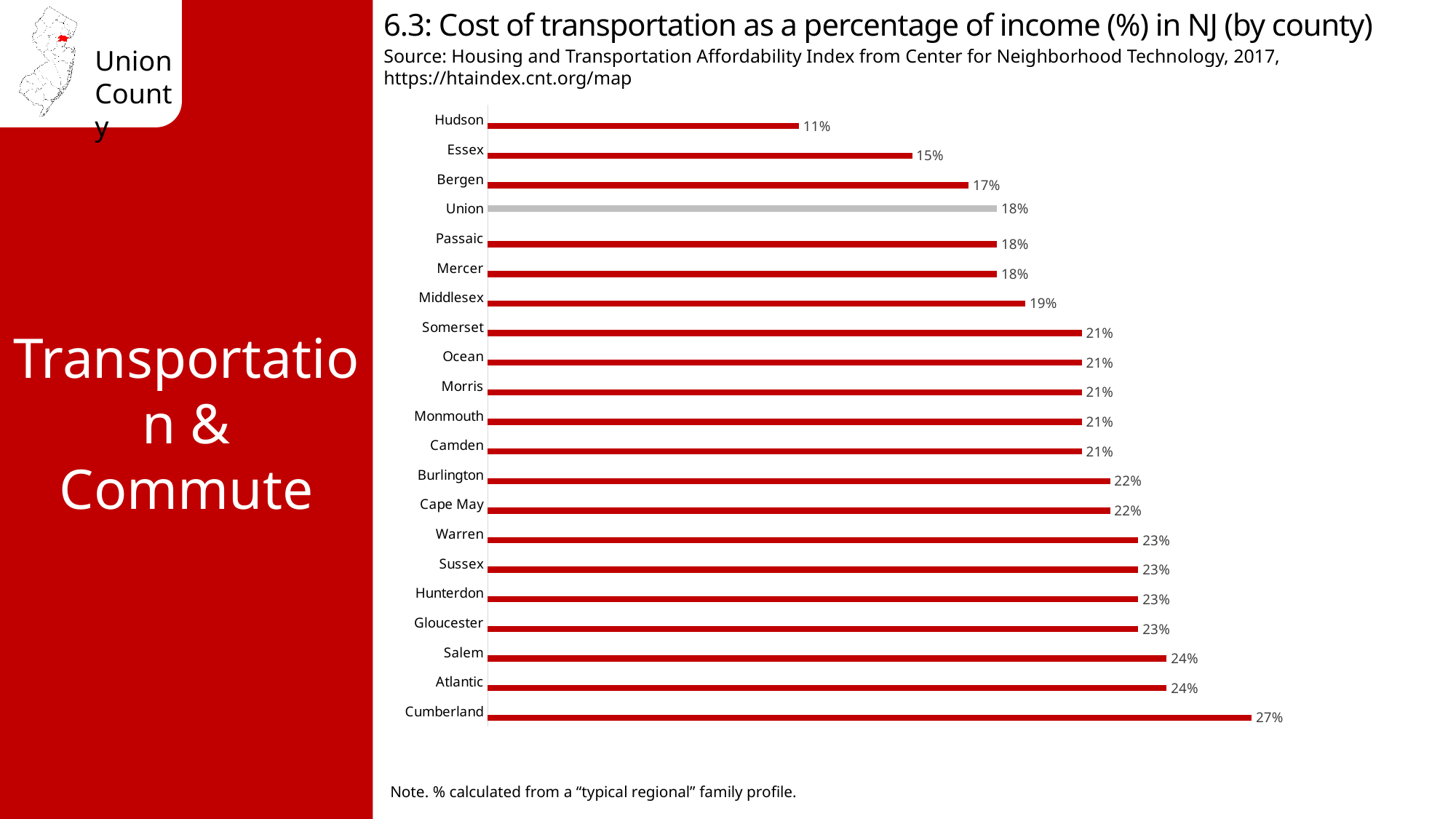
Which county has the lowest cost of transportation as a percentage of income? Hudson What is the difference in percentage points between Union and Essex? 3 Which county has a higher cost of transportation as a percentage of income, Essex or Warren? Warren What is the difference in percentage points between Cumberland and Hudson? 16 Which county's bar is shown in a different colour (grey) from the others? Union How many counties are shown in the chart? 21 What type of chart is used to show the cost of transportation by county? Bar chart What is the cost of transportation as a percentage of income for Middlesex county? 19% Which county has the highest cost of transportation as a percentage of income? Cumberland Which county has a higher cost of transportation as a percentage of income, Bergen or Salem? Salem What is the cost of transportation as a percentage of income for Union county? 18% What is the cost of transportation as a percentage of income for Hudson county? 11%